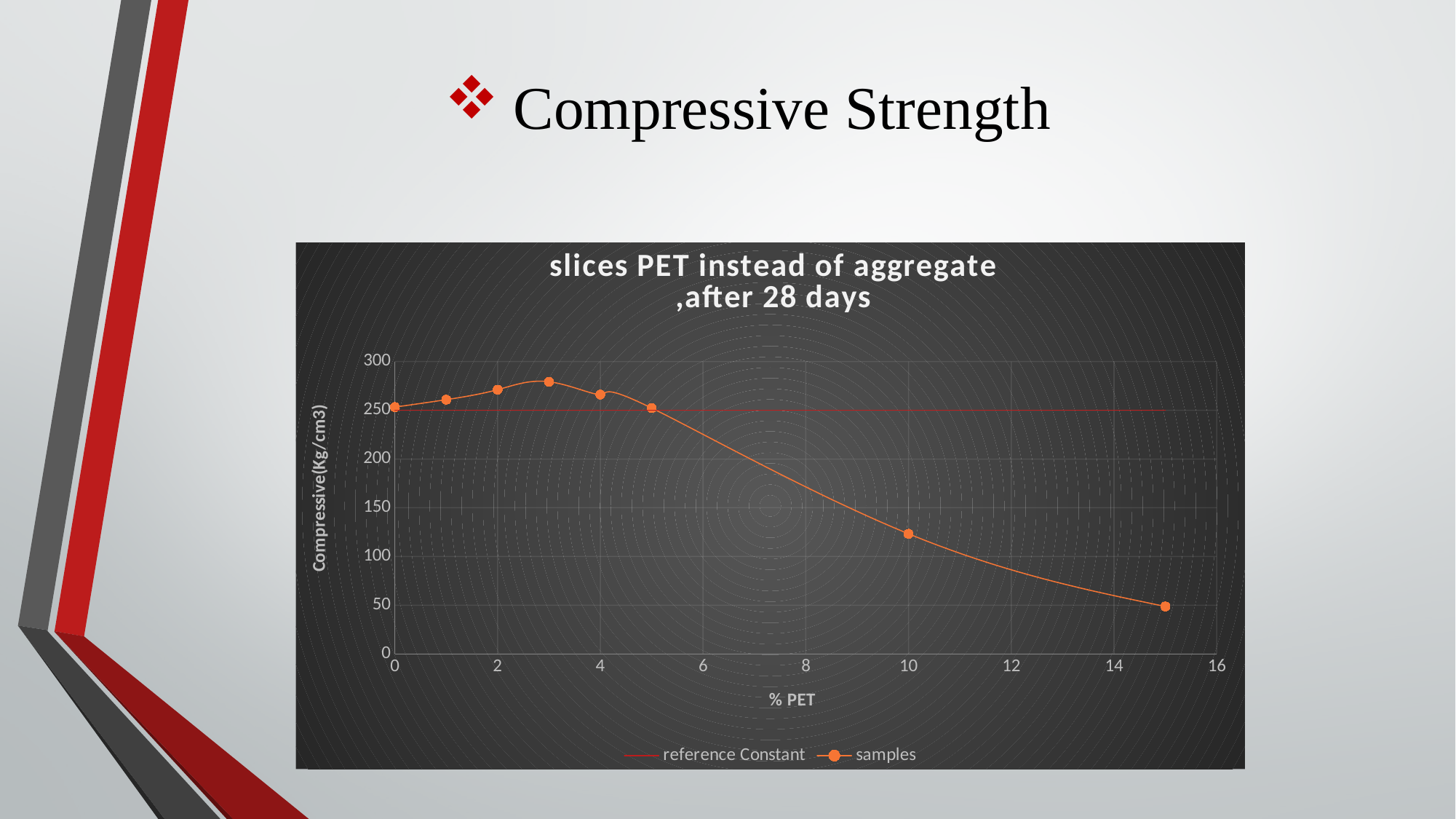
Which has the higher compressive strength, 3% PET or 10% PET? 3% PET Is the compressive strength at 3% PET greater or less than 250? greater How many series does the legend list? 2 What kind of chart is shown on the slide? line chart At which % PET value does the samples line reach its lowest compressive strength? 15 At which % PET value does the samples line reach its highest compressive strength? 3 What is the title of the chart? slices PET instead of aggregate ,after 28 days Is the compressive strength at 10% PET greater or less than 150? less How many data points are plotted on the samples line? 8 Is the compressive strength at 15% PET greater or less than 100? less Does the compressive strength rise or fall between 5% PET and 15% PET? fall